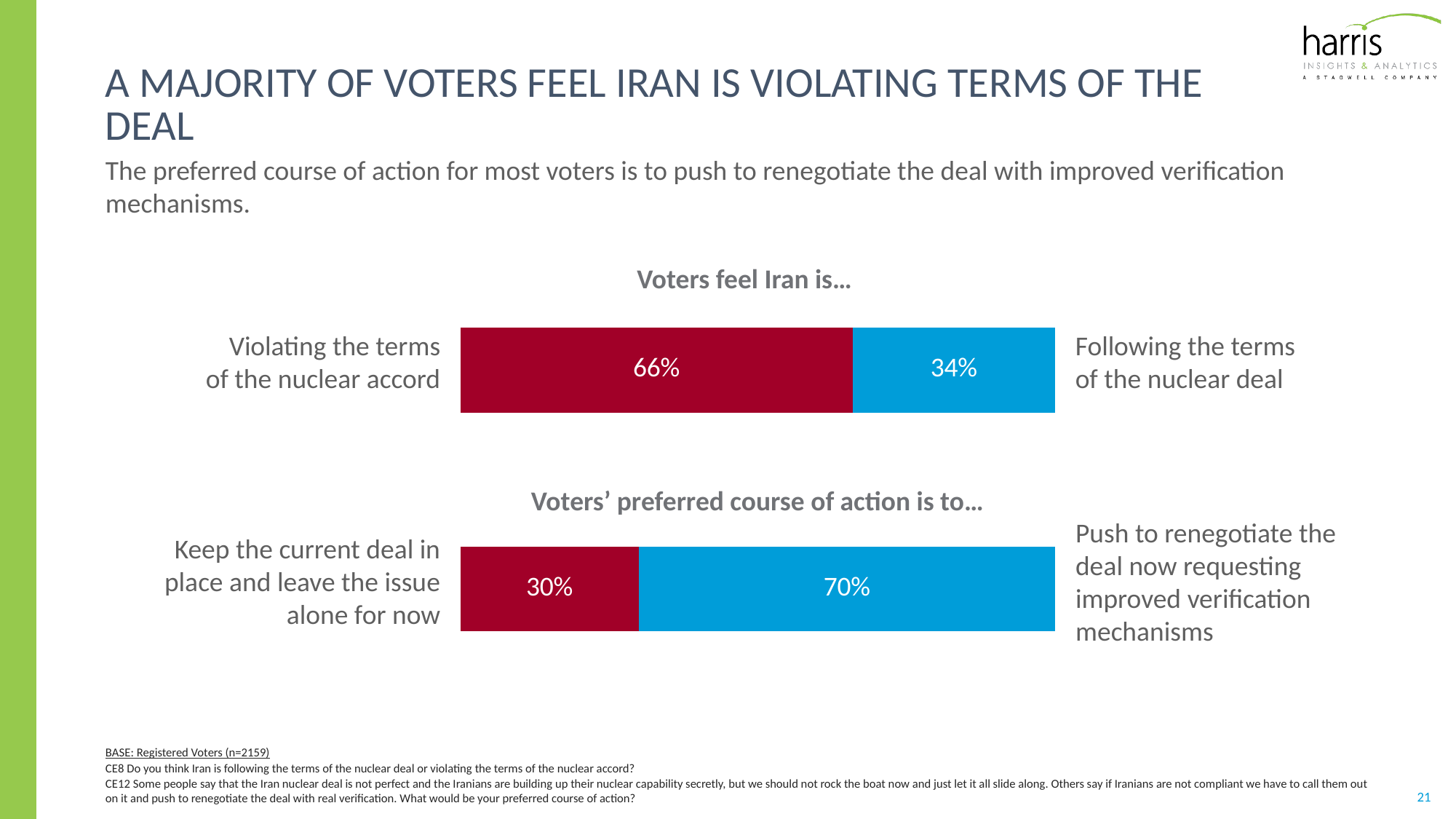
In the "Voters' preferred course of action is to..." chart, what percentage of voters prefer to push to renegotiate the deal now requesting improved verification mechanisms? 70% In the "Voters feel Iran is..." chart, what is the total of the two segments of the stacked bar? 100% In the "Voters feel Iran is..." chart, which is larger: the share who feel Iran is violating the terms or the share who feel Iran is following the terms? Violating the terms of the nuclear accord In the "Voters feel Iran is..." chart, what percentage of voters feel Iran is violating the terms of the nuclear accord? 66% In the "Voters feel Iran is..." chart, what percentage of voters feel Iran is following the terms of the nuclear deal? 34% In the "Voters' preferred course of action is to..." chart, what is the difference between the share preferring to push to renegotiate and the share preferring to keep the current deal? 40 percentage points In the "Voters feel Iran is..." chart, what is the difference between the share who feel Iran is violating the terms and the share who feel Iran is following the terms? 32 percentage points In the "Voters' preferred course of action is to..." chart, what colour is the segment for pushing to renegotiate the deal? Blue In the "Voters' preferred course of action is to..." chart, what percentage of voters prefer to keep the current deal in place and leave the issue alone for now? 30% What kind of chart is used for "Voters feel Iran is..."? Stacked horizontal bar chart In the "Voters' preferred course of action is to..." chart, which option has the higher share? Push to renegotiate the deal now requesting improved verification mechanisms In the "Voters' preferred course of action is to..." chart, which option has the lower share? Keep the current deal in place and leave the issue alone for now